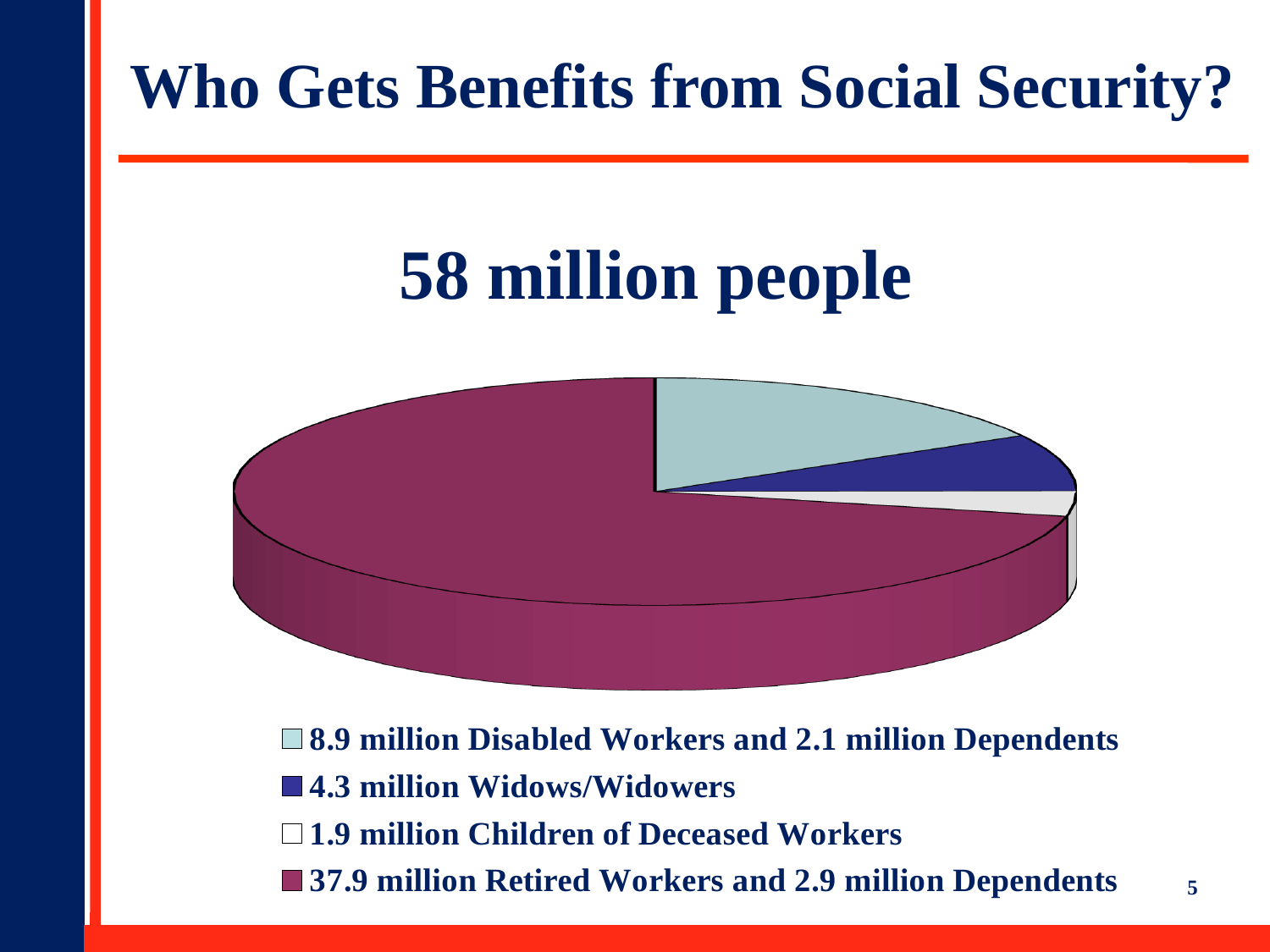
How many Children of Deceased Workers receive benefits according to the legend? 1.9 million How many Widows/Widowers receive benefits according to the legend? 4.3 million Which group makes up the largest slice of the pie chart? Retired Workers and Dependents Which slice is larger: Widows/Widowers or Children of Deceased Workers? Widows/Widowers How many Disabled Workers receive benefits according to the legend? 8.9 million According to the heading above the pie chart, how many people in total get benefits? 58 million people How many more Widows/Widowers than Children of Deceased Workers receive benefits? 2.4 million How many Retired Workers receive benefits according to the legend? 37.9 million What kind of chart is shown on the slide? pie chart Which group makes up the smallest slice of the pie chart? Children of Deceased Workers How many slices does the pie chart have? 4 What is the title of the slide? Who Gets Benefits from Social Security?